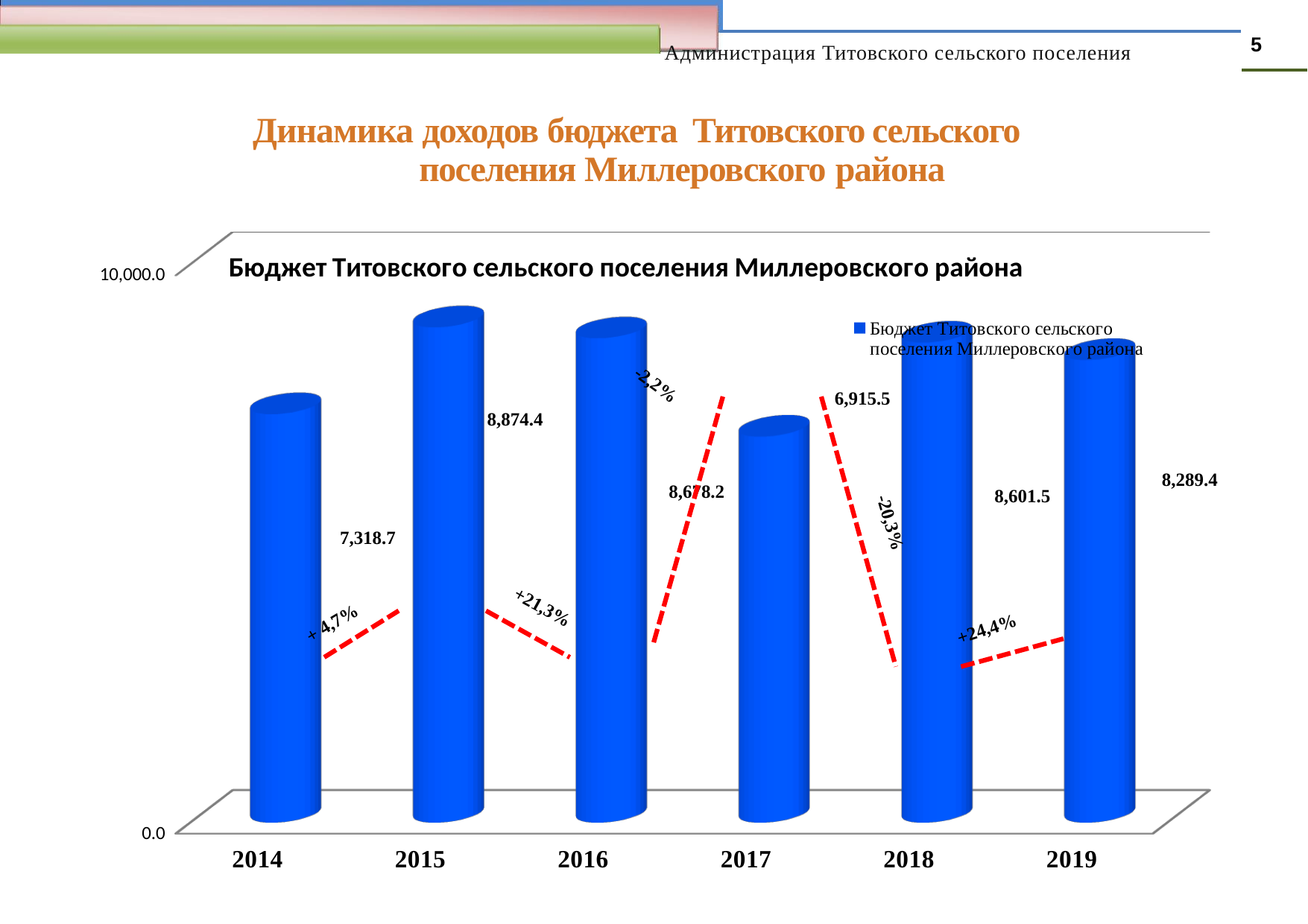
How many years are shown on the x axis of the chart? 6 Which year has the lowest budget value? 2017 What is the budget value shown for 2017? 6,915.5 Which year has the highest budget value? 2015 What is the difference between the budget values for 2015 and 2014? 1,555.7 How many series does the chart legend list? 1 What kind of chart is shown on the slide? Bar chart Do the budget values rise or fall from 2015 to 2017? Fall What is the budget value shown for 2019? 8,289.4 What is the difference between the budget values for 2018 and 2017? 1,686.0 Which year has the larger budget value, 2016 or 2018? 2016 What is the budget value shown for 2014? 7,318.7